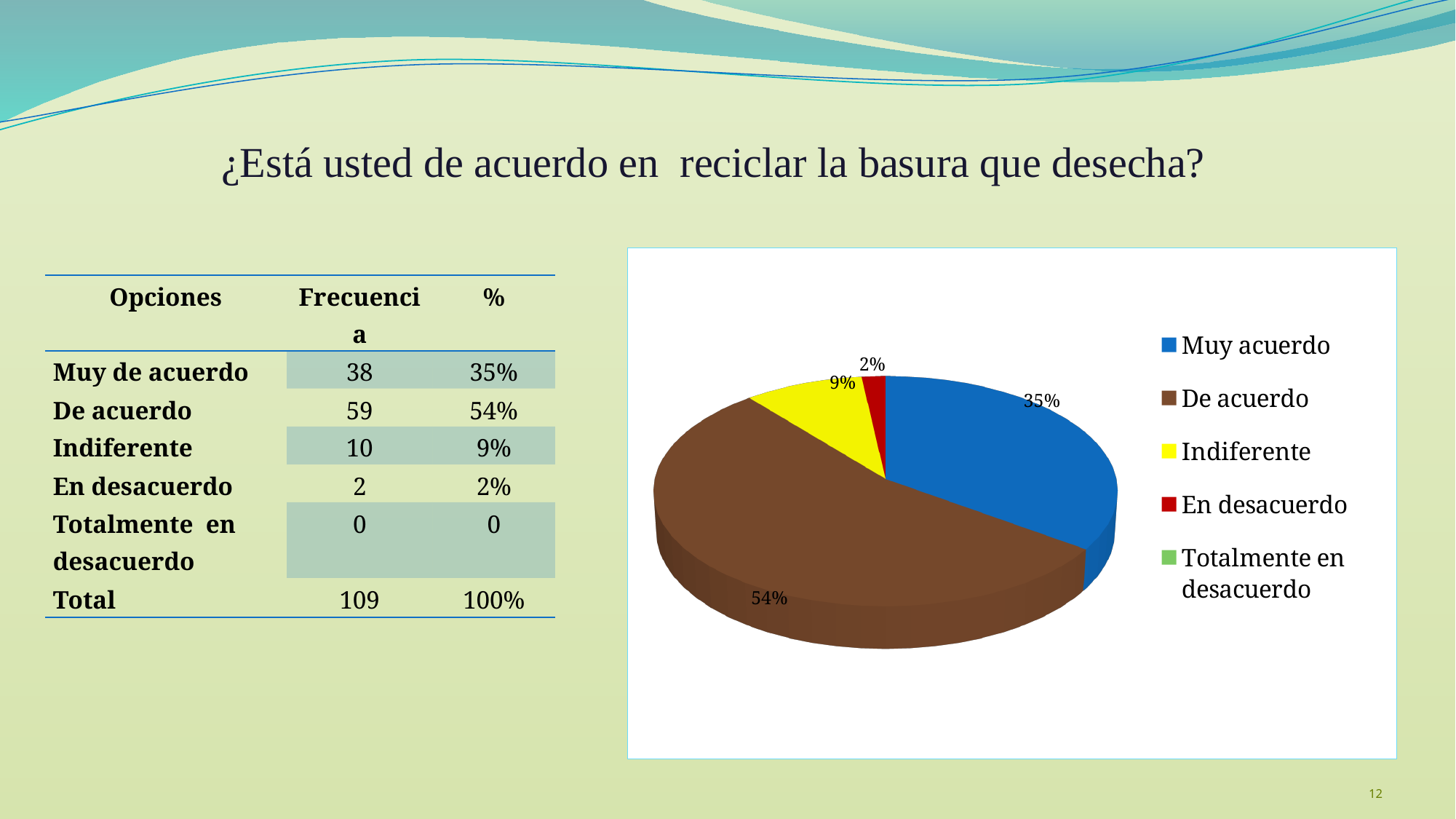
What is the difference in percentage points between De acuerdo and Muy acuerdo in the pie chart? 19 What colour is the Indiferente slice in the pie chart? yellow Which labelled slice of the pie chart is the smallest? En desacuerdo Which is larger in the pie chart, Indiferente or En desacuerdo? Indiferente What percentage does the pie chart show for Indiferente? 9% Which category has the largest slice of the pie chart? De acuerdo How many entries does the legend of the pie chart list? 5 What colour is the De acuerdo slice in the pie chart? brown What percentage does the pie chart show for En desacuerdo? 2% What percentage does the pie chart show for Muy acuerdo? 35% What percentage does the pie chart show for De acuerdo? 54% What kind of chart is shown on the slide? pie chart